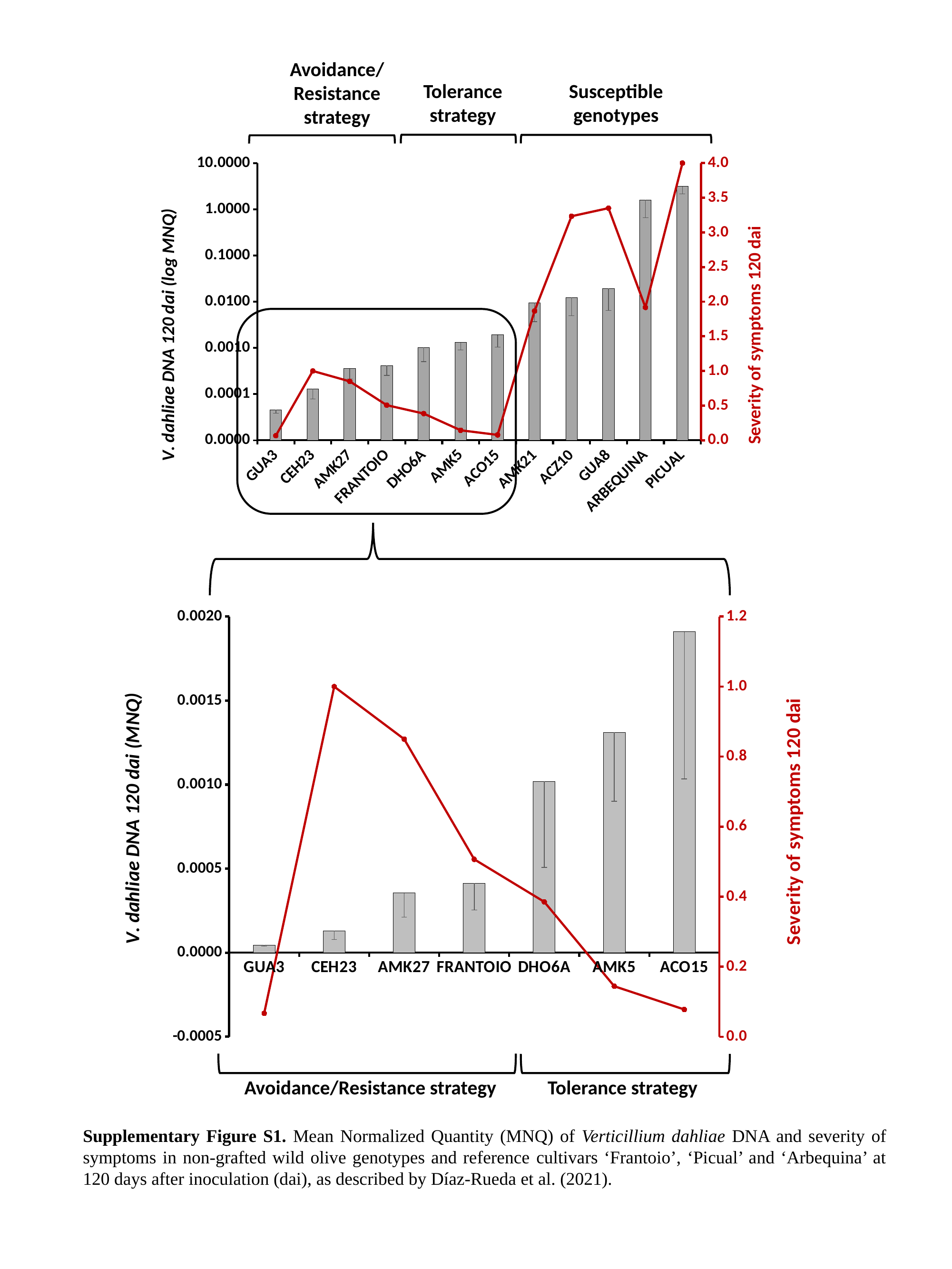
In the top chart, which genotype has the highest V. dahliae DNA (log MNQ) bar? PICUAL In the top chart, how many genotypes are shown on the x axis? 12 In the bottom chart, is the V. dahliae DNA (MNQ) value for AMK27 greater or less than 0.0005? less In the bottom chart, what is the severity of symptoms value for CEH23? 1.0 In the bottom chart, which genotype has the highest severity of symptoms? CEH23 In the bottom chart, how many genotypes are shown on the x axis? 7 In the bottom chart, does the severity of symptoms line rise or fall from CEH23 to ACO15? fall In the top chart, which genotype has the lowest V. dahliae DNA (log MNQ) bar? GUA3 In the bottom chart, is the V. dahliae DNA (MNQ) value for ACO15 greater or less than 0.0015? greater In the bottom chart, which has the larger V. dahliae DNA (MNQ) bar, AMK5 or DHO6A? AMK5 In the top chart, is the V. dahliae DNA (log MNQ) value for ARBEQUINA greater or less than 1.0000? greater In the top chart, what is the severity of symptoms value for PICUAL? 4.0